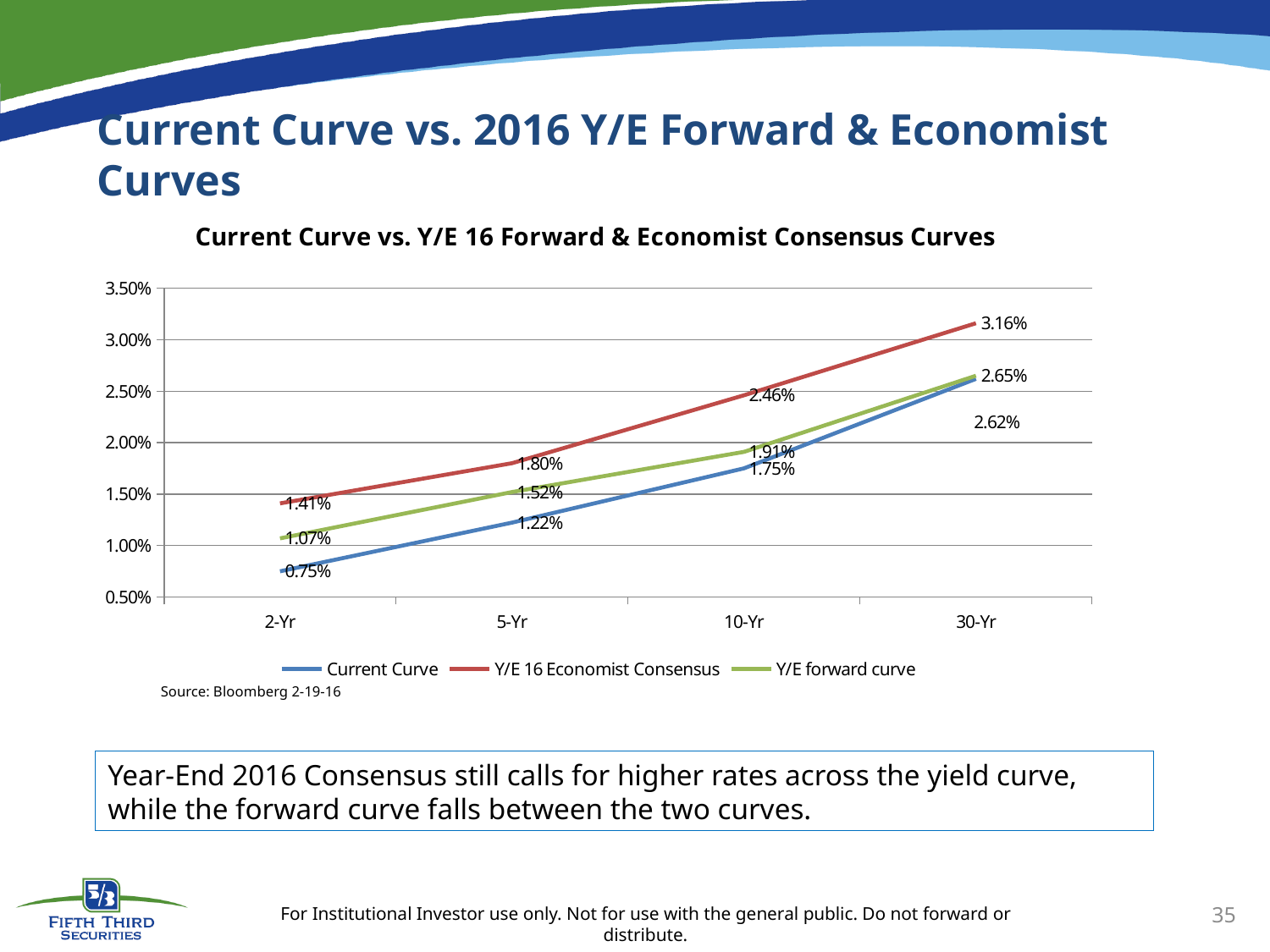
How many maturity points are plotted along the x axis? 4 How many series does the legend list? 3 At which maturity is the Current Curve lowest? 2-Yr What is the difference between the Y/E 16 Economist Consensus and the Current Curve at 2-Yr? 0.66% What is the value of the Current Curve at 2-Yr? 0.75% What is the value of the Y/E 16 Economist Consensus curve at 30-Yr? 3.16% What is the value of the Y/E forward curve at 5-Yr? 1.52% What is the value of the Y/E 16 Economist Consensus curve at 10-Yr? 2.46% Do the values of the Current Curve rise or fall from 2-Yr to 30-Yr? rise Which is larger at 10-Yr, the Y/E 16 Economist Consensus or the Current Curve? Y/E 16 Economist Consensus At which maturity is the Y/E 16 Economist Consensus curve highest? 30-Yr What type of chart is shown on the slide? line chart